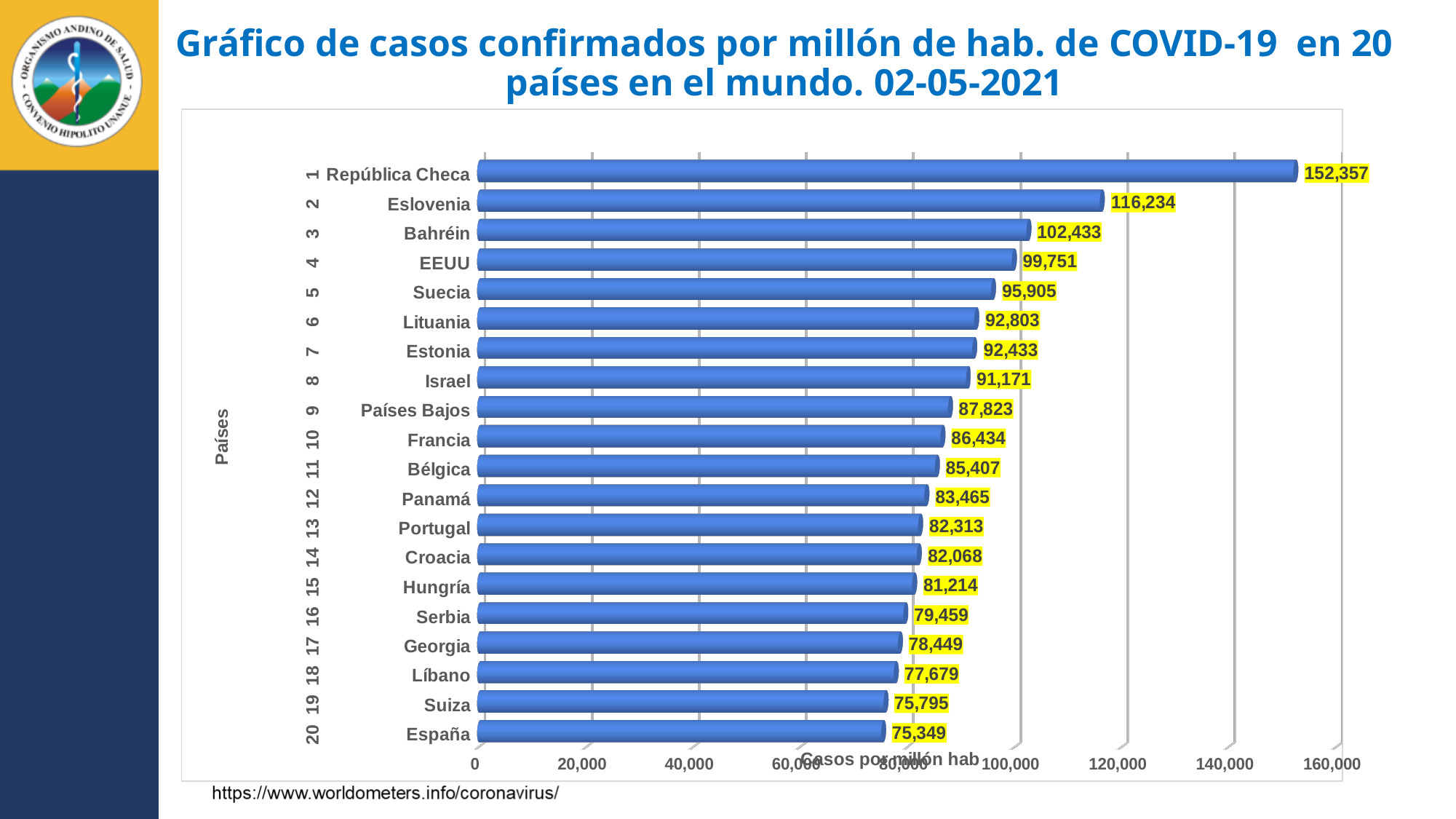
What kind of chart is shown on the slide? bar chart What is the value for España? 75,349 Is the value for Eslovenia greater or less than 100,000? greater Which has a larger value, Bahréin or Francia? Bahréin What is the value for Israel? 91,171 What is the difference between the values for EEUU and Suecia? 3,846 What is the value for República Checa? 152,357 How many countries are shown in the chart? 20 Which country has the highest number of confirmed cases per million inhabitants? República Checa Which country has the lowest number of confirmed cases per million inhabitants? España What is the difference between the values for República Checa and Eslovenia? 36,123 What is the label of the vertical axis? Países